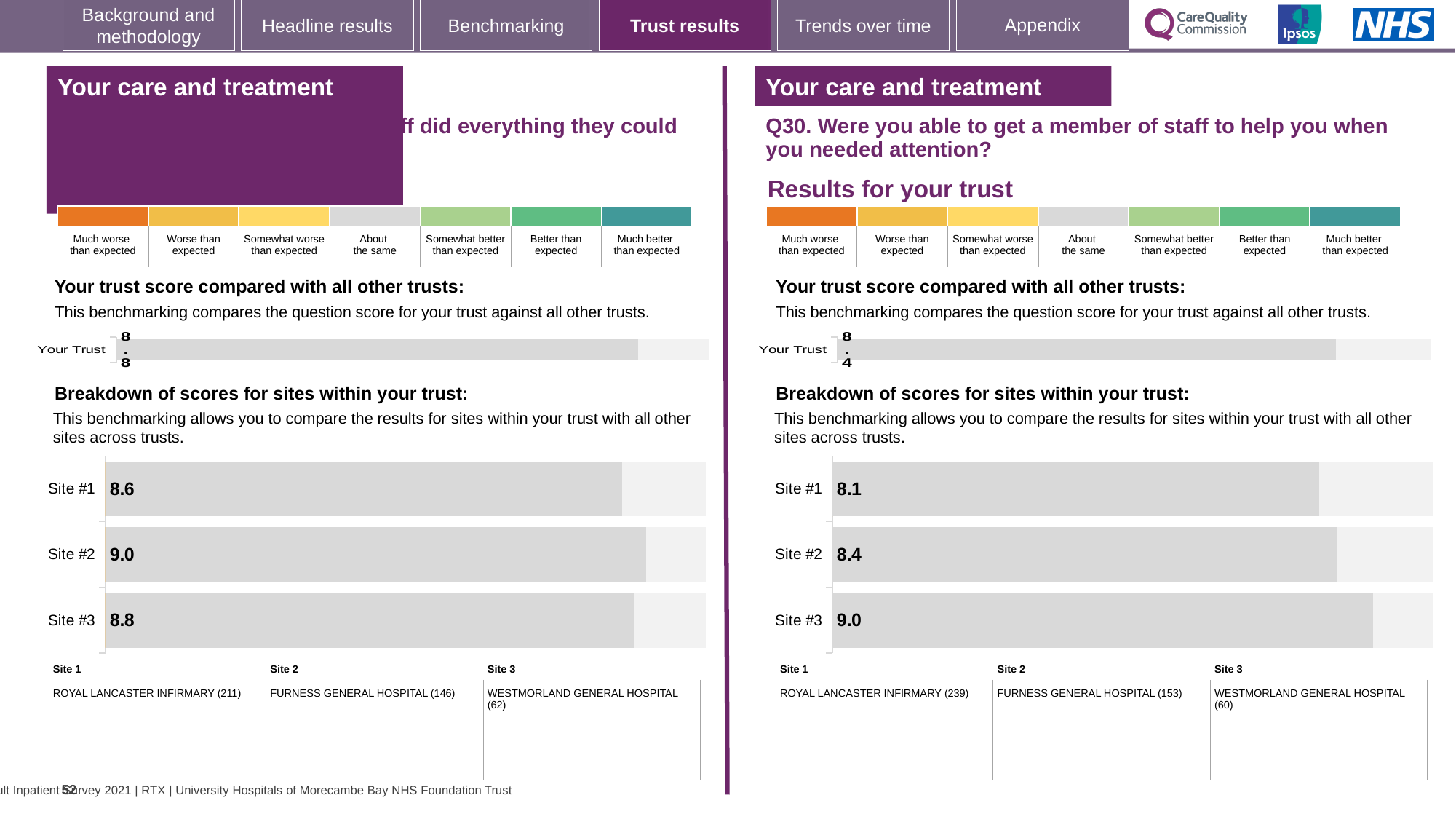
In the right-hand (Q30) 'Your trust score compared with all other trusts' chart, what is the score for Your Trust? 8.4 In the right-hand (Q30) 'Breakdown of scores for sites within your trust' chart, which is larger, the score for Site #1 or Site #2? Site #2 In the right-hand (Q30) 'Breakdown of scores for sites within your trust' chart, what is the difference between the scores for Site #3 and Site #1? 0.9 In the right-hand (Q30) 'Breakdown of scores for sites within your trust' chart, what is the score for Site #1? 8.1 In the left-hand 'Breakdown of scores for sites within your trust' chart, what is the difference between the scores for Site #2 and Site #1? 0.4 What kind of chart is the right-hand (Q30) 'Breakdown of scores for sites within your trust' chart? Bar chart In the left-hand 'Breakdown of scores for sites within your trust' chart, what is the score for Site #2? 9.0 In the left-hand 'Breakdown of scores for sites within your trust' chart, what is the score for Site #1? 8.6 In the right-hand (Q30) 'Breakdown of scores for sites within your trust' chart, what is the score for Site #3? 9.0 In the left-hand 'Breakdown of scores for sites within your trust' chart, which site has the lowest score? Site #1 In the right-hand (Q30) 'Breakdown of scores for sites within your trust' chart, which site has the highest score? Site #3 In the left-hand 'Breakdown of scores for sites within your trust' chart, how many sites are shown? 3